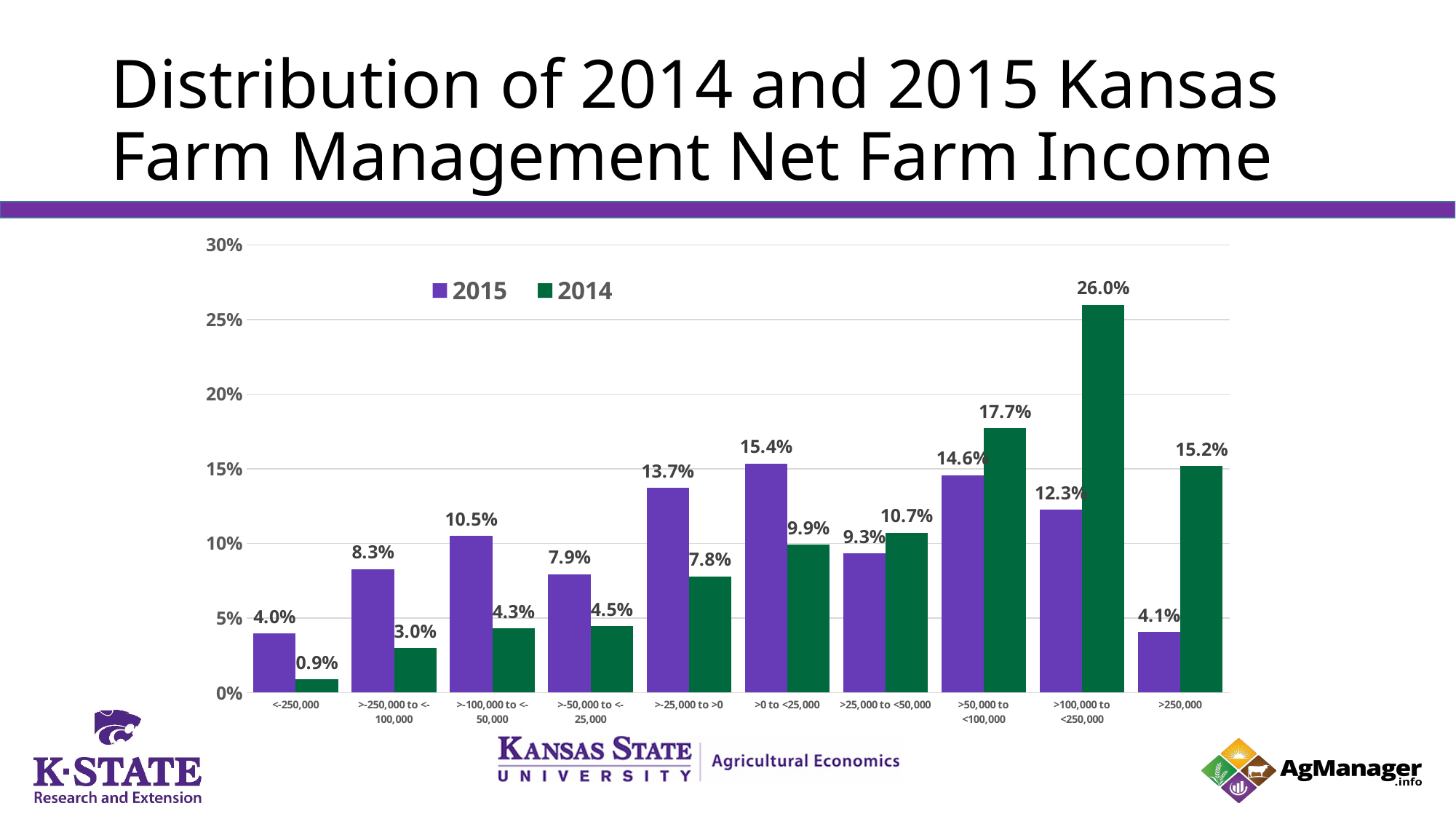
How many series does the legend list? 2 Which colour represents the 2015 series? Purple Is the 2015 value for the >-25,000 to >0 category greater or less than 10%? greater What is the 2015 value for the >0 to <25,000 category? 15.4% Which category has the highest 2015 value? >0 to <25,000 Which category has the lowest 2014 value? <-250,000 What is the difference between the 2014 and 2015 values for the >250,000 category? 11.1% Which is larger for the >25,000 to <50,000 category, the 2015 value or the 2014 value? 2014 What kind of chart is shown on the slide? Bar chart How many income categories are shown on the x axis? 10 What is the 2014 value for the <-250,000 category? 0.9% What is the 2014 value for the >100,000 to <250,000 category? 26.0%